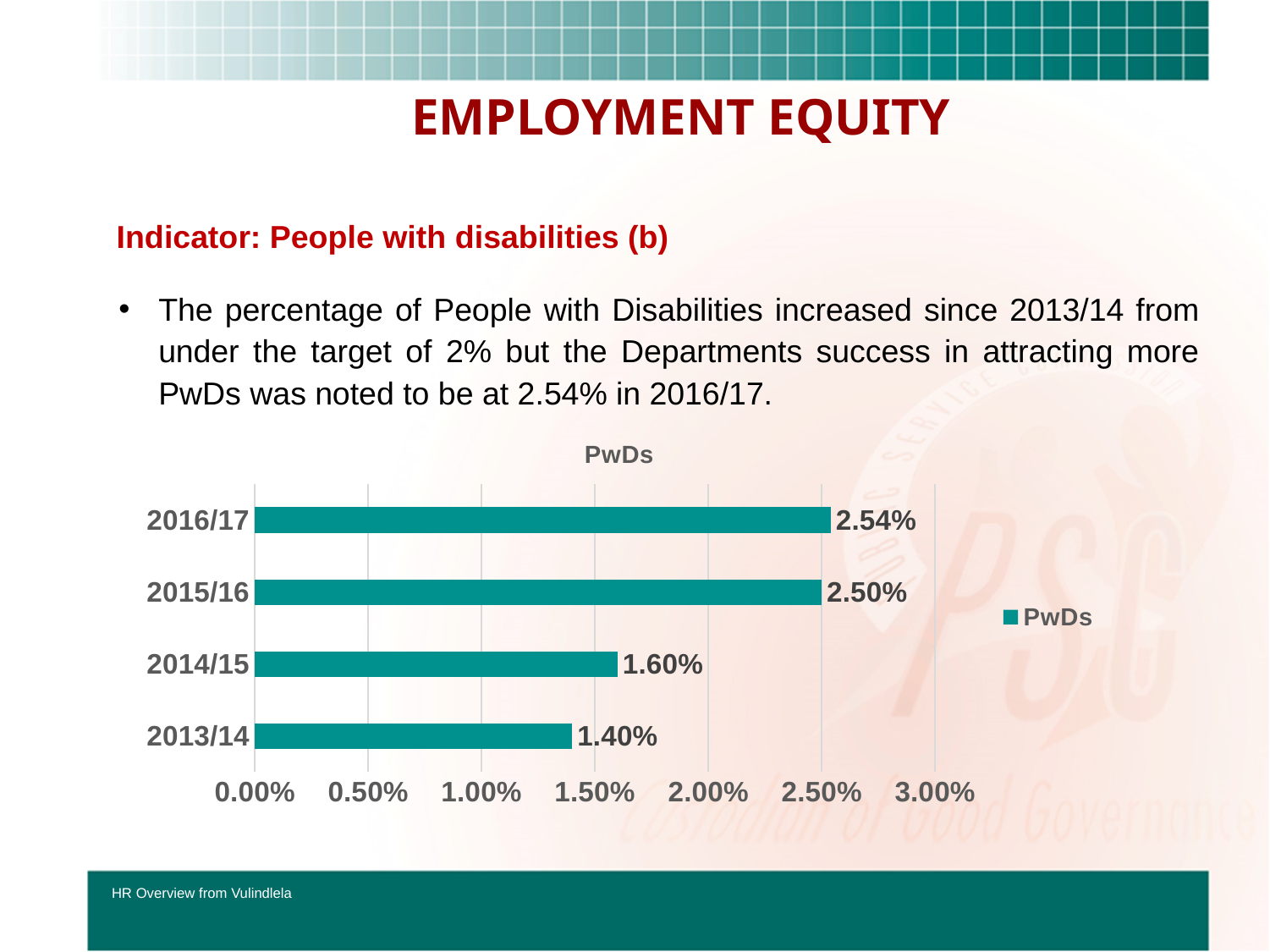
Which year has the lowest PwDs value? 2013/14 Is the PwDs value for 2013/14 greater or less than 1.50%? less What kind of chart is shown on the slide? Bar chart Which year has the highest PwDs value? 2016/17 Which is larger, the PwDs value for 2014/15 or for 2015/16? 2015/16 What is the PwDs value for 2013/14? 1.40% What is the difference between the PwDs values for 2016/17 and 2013/14? 1.14% What is the difference between the PwDs values for 2015/16 and 2014/15? 0.90% How many years are shown in the chart? 4 What is the title of the chart? PwDs What is the PwDs value for 2014/15? 1.60% What is the PwDs value for 2016/17? 2.54%